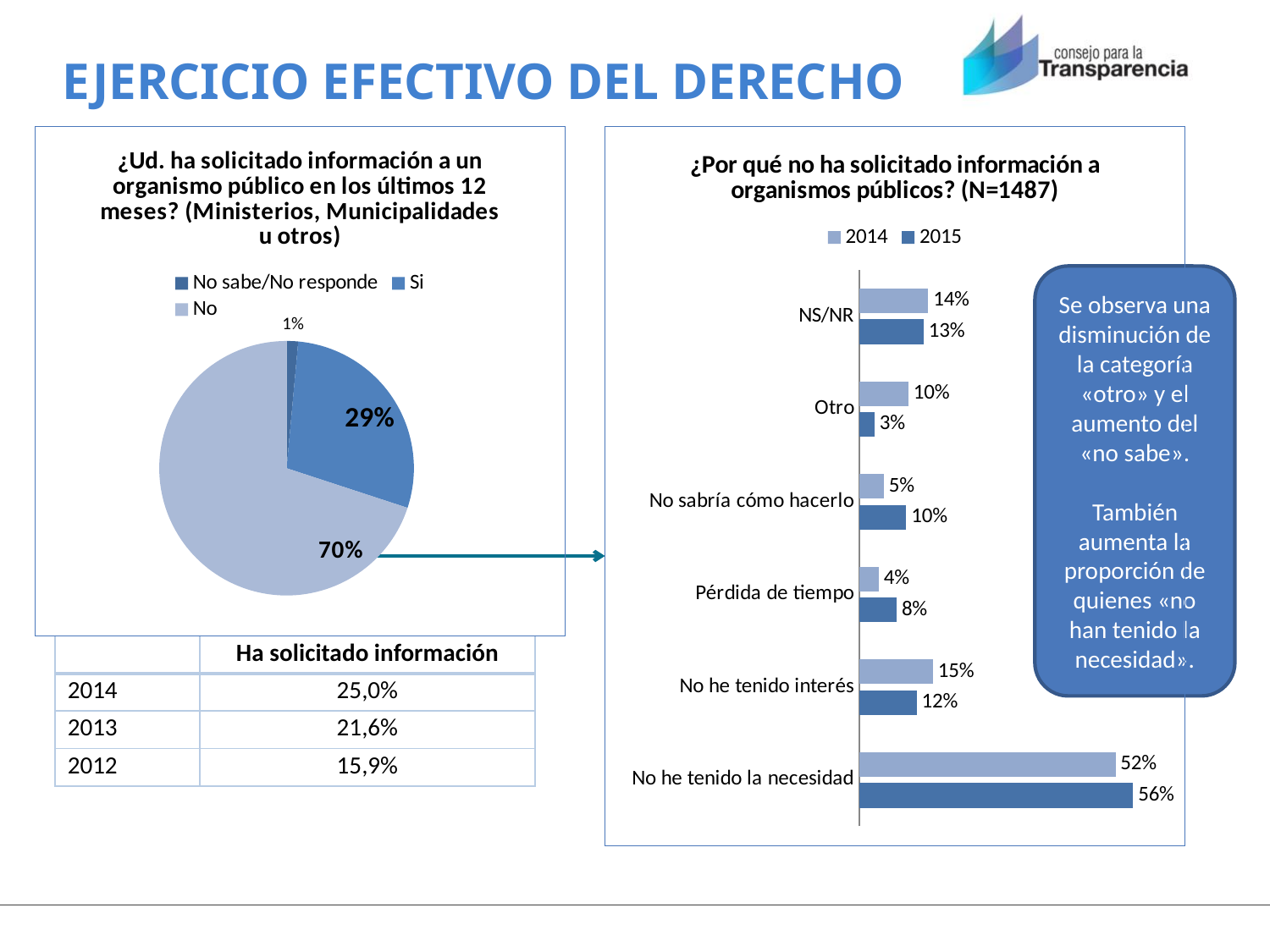
In the pie chart on the left, which category has the smallest slice? No sabe/No responde In the bar chart on the right, how many series does the legend list? 2 In the bar chart on the right, what is the difference between the 2014 and 2015 values for "Otro"? 7% In the bar chart on the right, what is the 2015 value for "No he tenido la necesidad"? 56% In the pie chart on the left, what share of respondents answered "Si"? 29% In the bar chart on the right, for "No sabría cómo hacerlo", which year has the larger value, 2014 or 2015? 2015 In the bar chart on the right, what is the 2014 value for "Otro"? 10% In the pie chart on the left, what share of respondents answered "No"? 70% In the bar chart on the right, how many categories are shown? 6 What kind of chart is the chart on the left of the slide? Pie chart What kind of chart is the chart titled "¿Por qué no ha solicitado información a organismos públicos? (N=1487)"? Bar chart In the bar chart on the right, which category has the highest 2014 value? No he tenido la necesidad